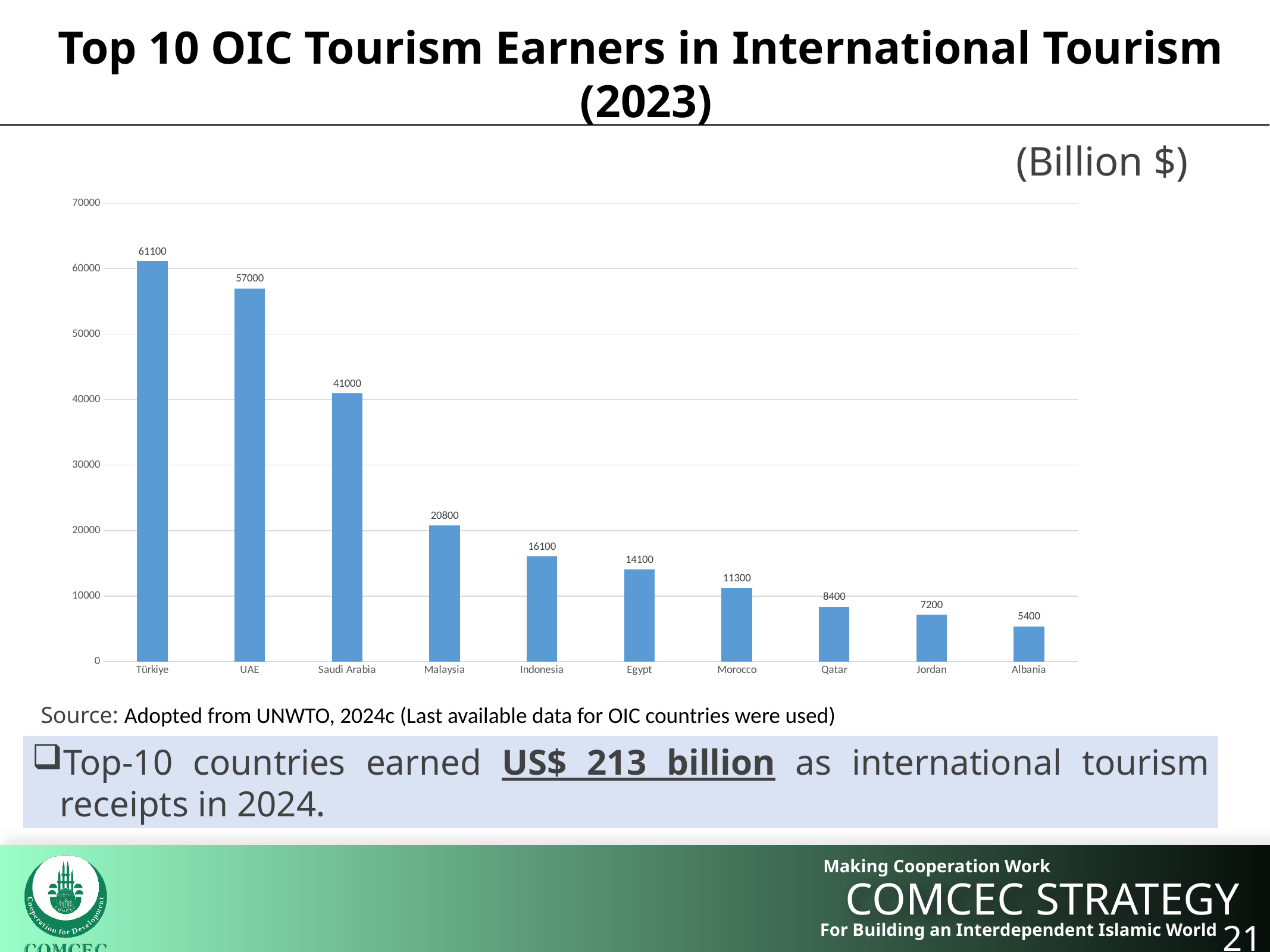
What is the value for Saudi Arabia? 41000 Which is larger, the value for Egypt or the value for Qatar? Egypt How many countries are shown in the chart? 10 What is the value for Morocco? 11300 What is the difference between the values for Malaysia and Indonesia? 4700 What is the difference between the values for Türkiye and UAE? 4100 Which country has the highest value? Türkiye Do the values rise or fall from left to right along the x axis? fall What is the value for Türkiye? 61100 What kind of chart is shown on the slide? bar chart Is the value for Jordan greater or less than 10000? less Which country has the lowest value? Albania